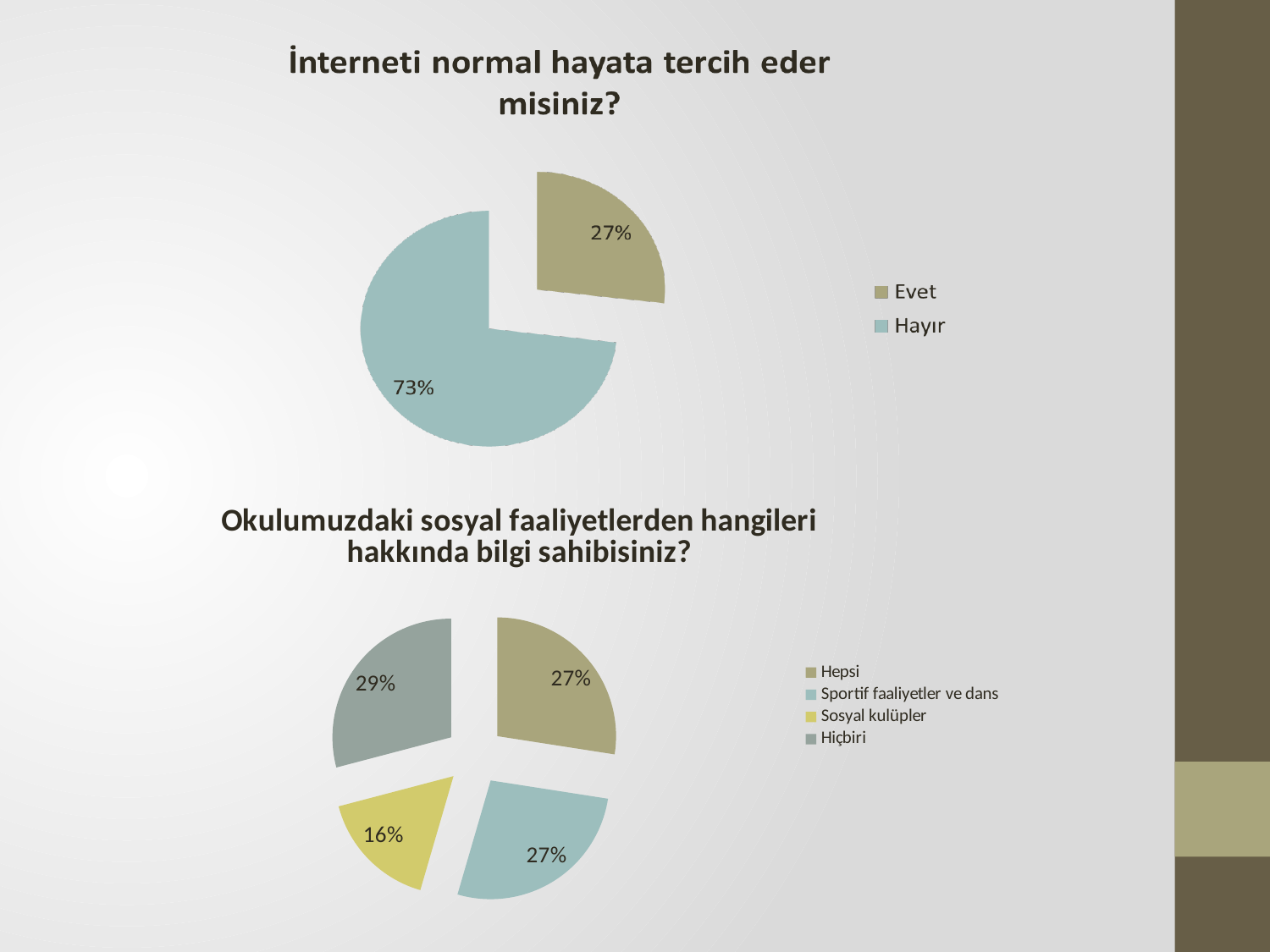
In the top chart 'İnterneti normal hayata tercih eder misiniz?', which category has the larger share? Hayır In the bottom chart 'Okulumuzdaki sosyal faaliyetlerden hangileri hakkında bilgi sahibisiniz?', what percentage is shown for Hiçbiri? 29% In the bottom chart 'Okulumuzdaki sosyal faaliyetlerden hangileri hakkında bilgi sahibisiniz?', what percentage is shown for Sosyal kulüpler? 16% How many entries does the legend of the top chart 'İnterneti normal hayata tercih eder misiniz?' list? 2 What kind of chart is the top chart 'İnterneti normal hayata tercih eder misiniz?'? Pie chart In the bottom chart 'Okulumuzdaki sosyal faaliyetlerden hangileri hakkında bilgi sahibisiniz?', which category has the largest share? Hiçbiri In the bottom chart 'Okulumuzdaki sosyal faaliyetlerden hangileri hakkında bilgi sahibisiniz?', which category has the smallest share? Sosyal kulüpler In the top chart 'İnterneti normal hayata tercih eder misiniz?', what is the difference in percentage points between Hayır and Evet? 46 In the bottom chart 'Okulumuzdaki sosyal faaliyetlerden hangileri hakkında bilgi sahibisiniz?', what is the difference in percentage points between Hiçbiri and Sosyal kulüpler? 13 In the top chart 'İnterneti normal hayata tercih eder misiniz?', what percentage is shown for Evet? 27% In the top chart 'İnterneti normal hayata tercih eder misiniz?', what percentage is shown for Hayır? 73% How many categories does the bottom chart 'Okulumuzdaki sosyal faaliyetlerden hangileri hakkında bilgi sahibisiniz?' show? 4